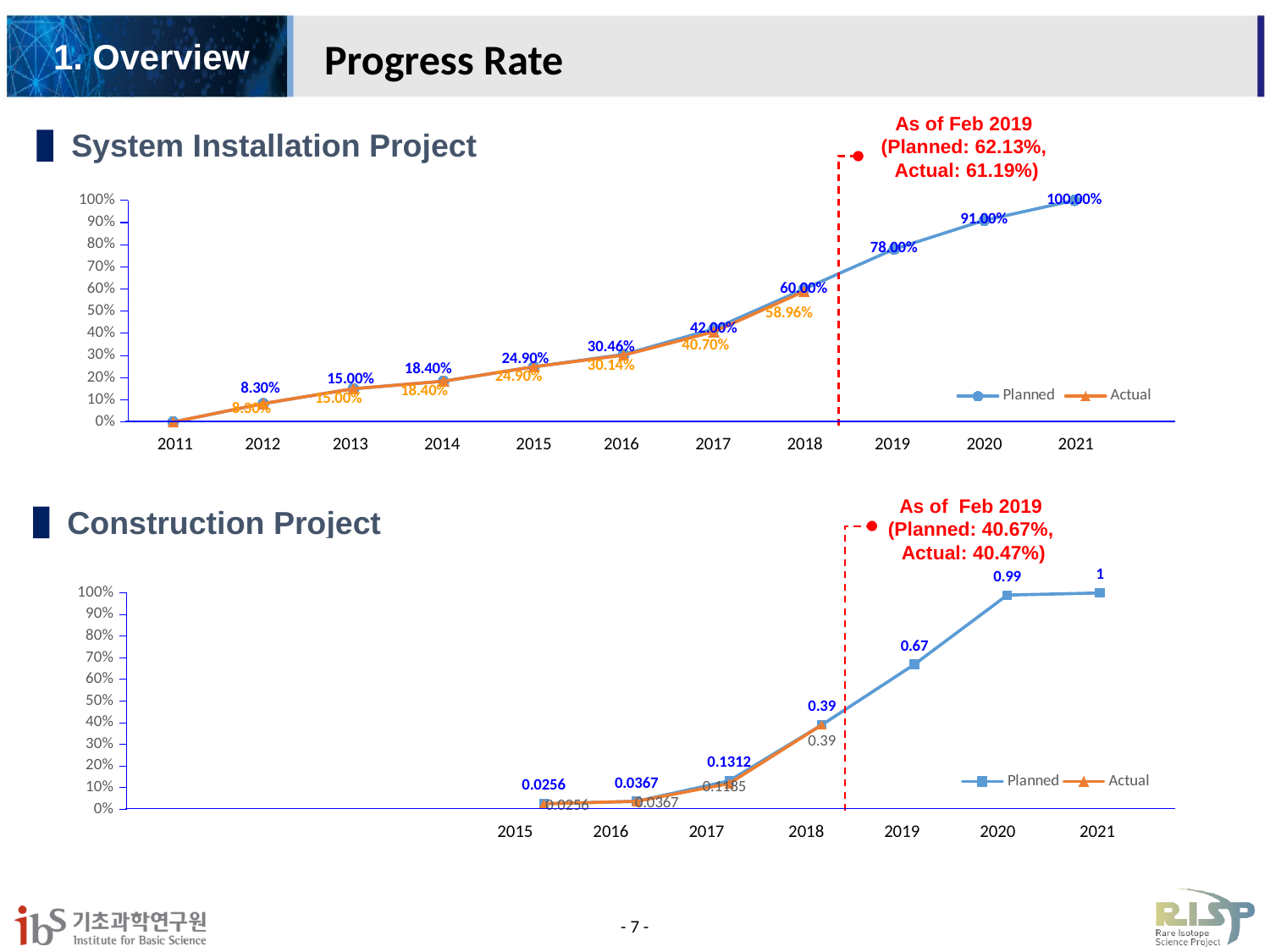
How many years are shown on the x axis of the System Installation Project chart? 11 In the Construction Project chart, what is the difference between the Planned and Actual values for 2017? 0.0127 In the Construction Project chart, what is the Planned value for 2020? 0.99 In the System Installation Project chart, what is the difference between the Planned and Actual values for 2017? 1.30% In the System Installation Project chart, what is the Actual value for 2018? 58.96% How many series does the legend of the System Installation Project chart list? 2 In the Construction Project chart, do the Planned values rise or fall from 2015 to 2021? Rise In the System Installation Project chart, what is the Planned value for 2021? 100.00% In the System Installation Project chart, which is larger for 2018, the Planned or the Actual value? Planned What kind of chart is the System Installation Project chart? Line chart In the Construction Project chart, what is the Actual value for 2017? 0.1185 In the System Installation Project chart, what is the Planned value for 2018? 60.00%